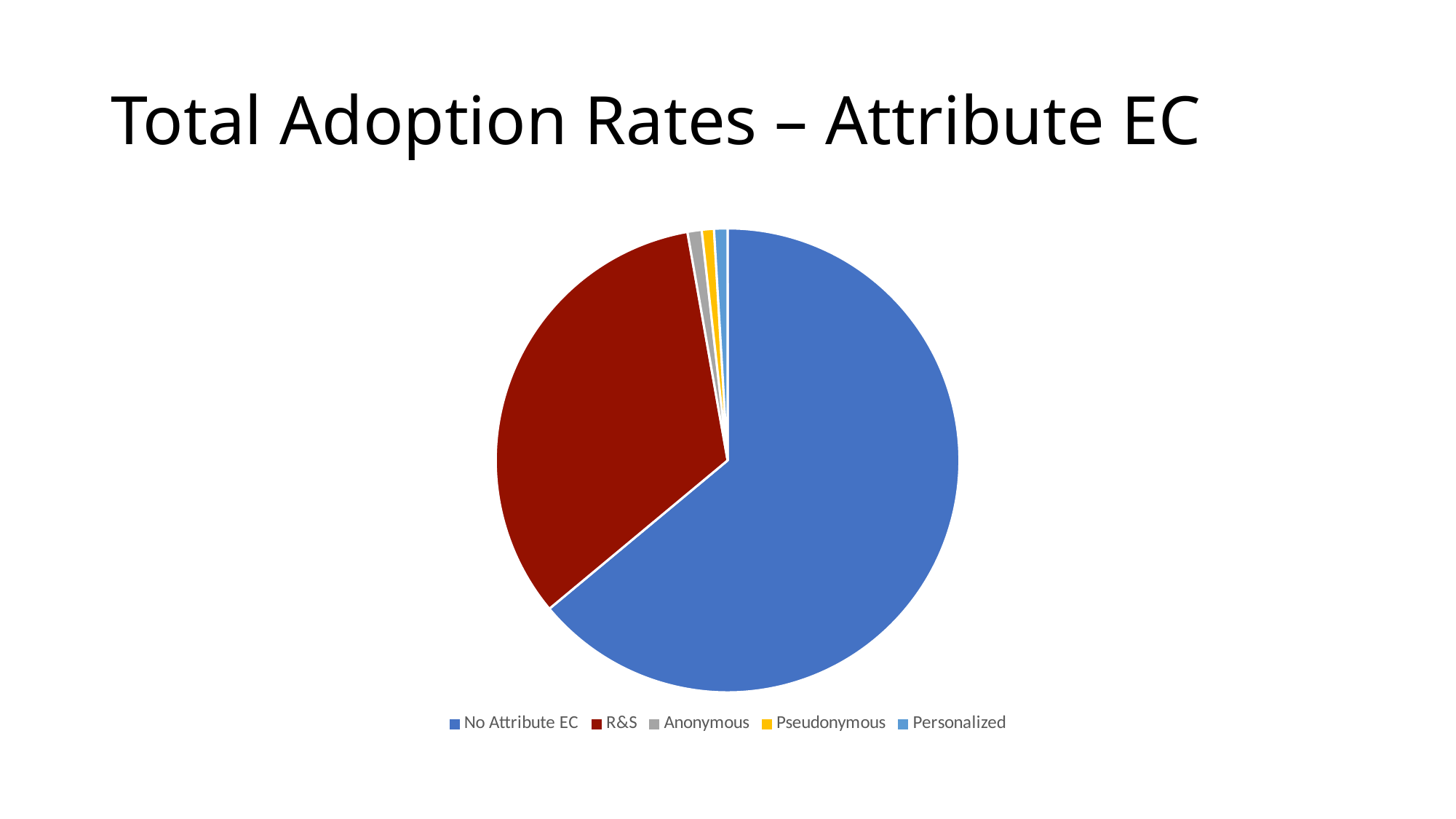
What kind of chart is shown on the slide? pie chart Is the R&S slice more or less than half of the pie? less Which category has the second-largest slice of the pie chart? R&S Which slice is larger, No Attribute EC or R&S? No Attribute EC Is the No Attribute EC slice more or less than half of the pie? more What is the title of the slide containing the pie chart? Total Adoption Rates – Attribute EC Which category has the largest slice of the pie chart? No Attribute EC How many categories does the legend of the pie chart list? 5 What colour is the R&S slice in the pie chart? dark red Which slice is larger, R&S or Anonymous? R&S